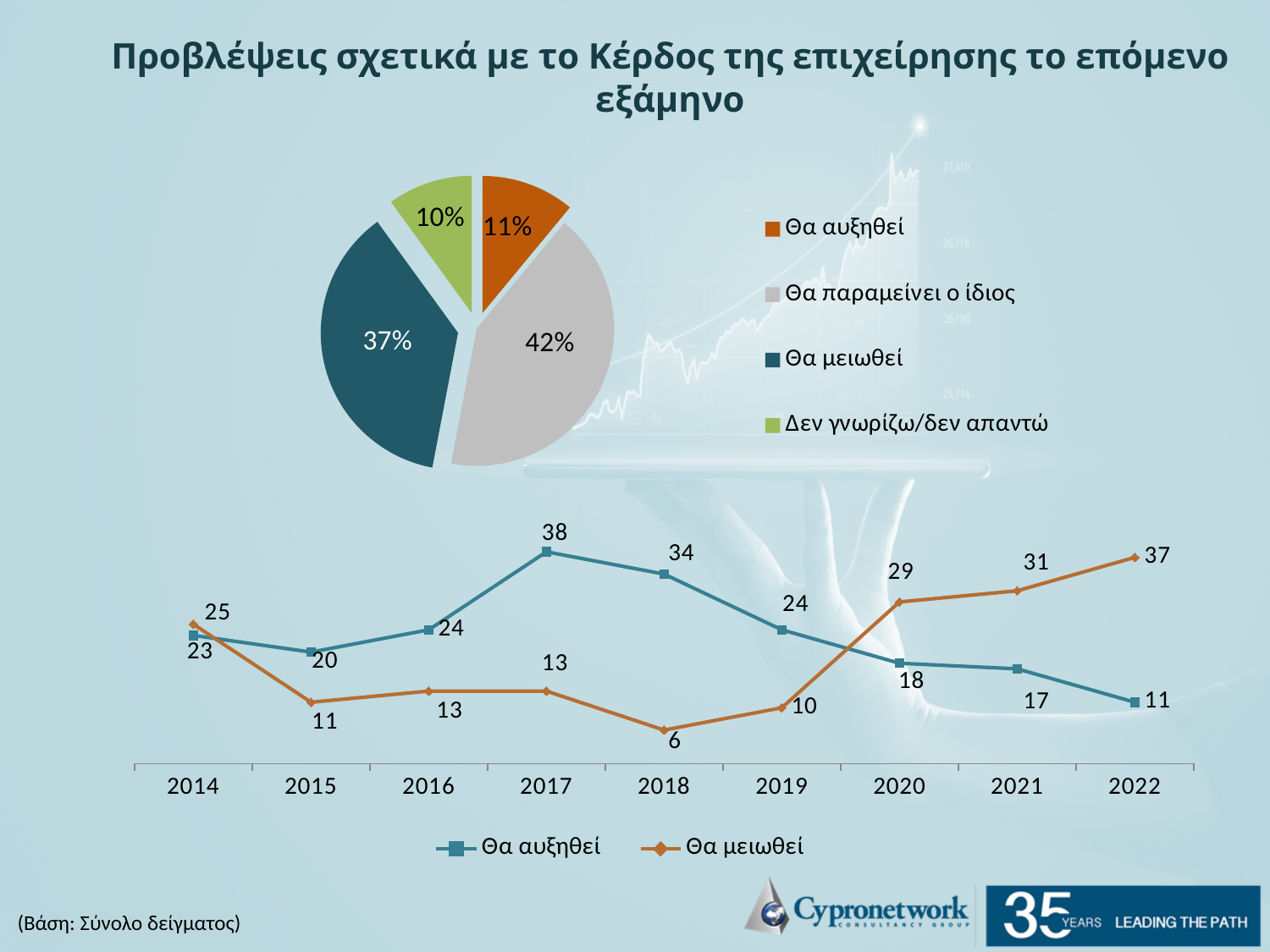
In the line chart at the bottom of the slide, in which year does 'Θα μειωθεί' reach its highest value? 2022 In the pie chart at the top of the slide, how many categories does the legend list? 4 In the line chart at the bottom of the slide, does the 'Θα αυξηθεί' series rise or fall from 2017 to 2022? Fall In the pie chart at the top of the slide, which category has the smallest slice? Δεν γνωρίζω/δεν απαντώ In the line chart at the bottom of the slide, what is the difference between 'Θα μειωθεί' and 'Θα αυξηθεί' in 2022? 26 In the line chart at the bottom of the slide, how many years are shown on the x axis? 9 In the line chart at the bottom of the slide, what is the value for 'Θα μειωθεί' in 2018? 6 In the pie chart at the top of the slide, what is the difference in percentage points between 'Θα παραμείνει ο ίδιος' and 'Θα μειωθεί'? 5 What kind of chart is the chart at the bottom of the slide? Line chart In the pie chart at the top of the slide, what share is labelled for 'Θα παραμείνει ο ίδιος'? 42% In the line chart at the bottom of the slide, what is the value for 'Θα αυξηθεί' in 2017? 38 In the line chart at the bottom of the slide, which series has the larger value in 2020, 'Θα αυξηθεί' or 'Θα μειωθεί'? Θα μειωθεί